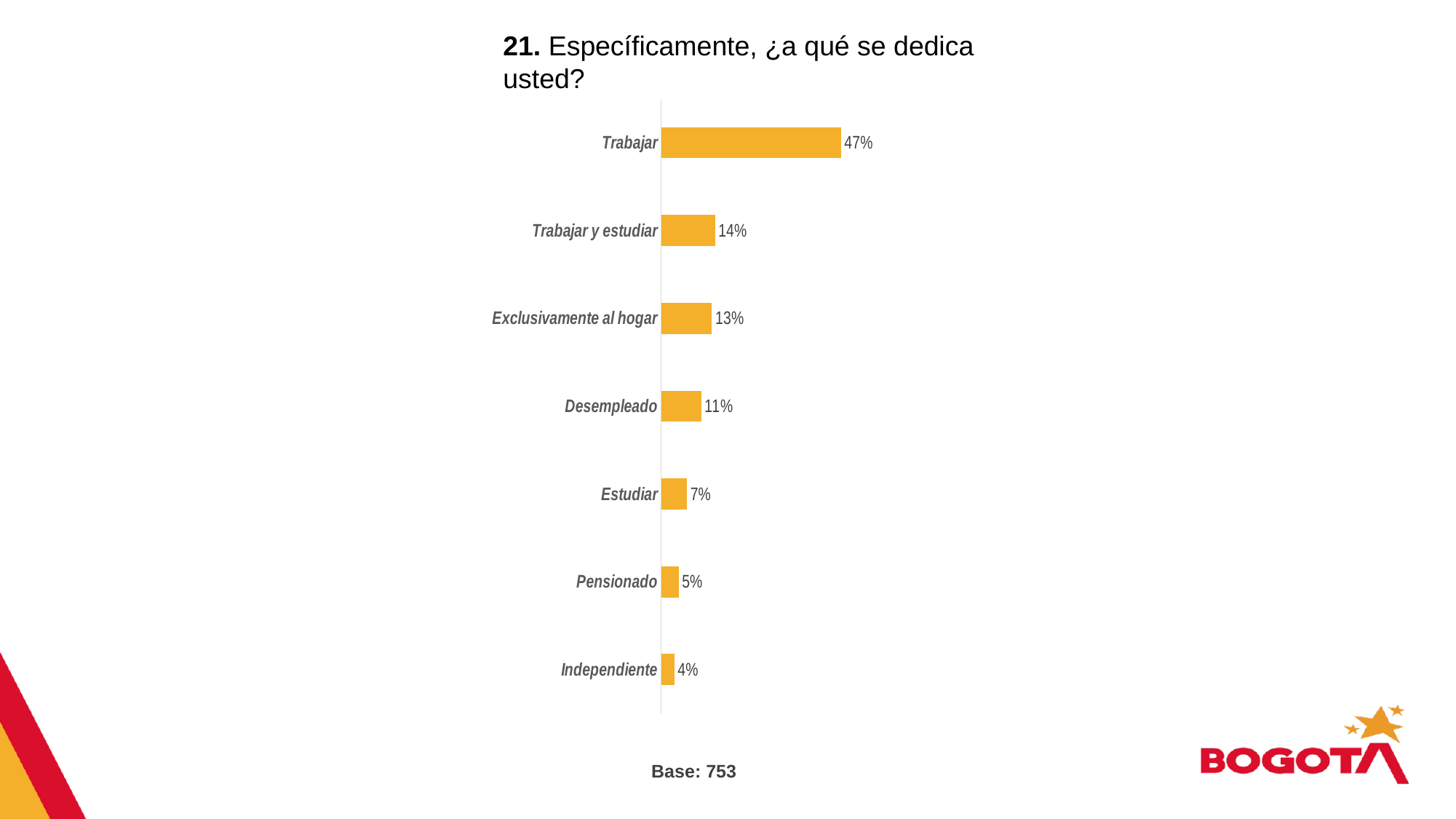
Which category has the lowest value? Independiente Which category has the highest value? Trabajar What is the base (number of respondents) shown below the chart? 753 What is the value for Exclusivamente al hogar? 13% Which is larger, the value for Desempleado or the value for Estudiar? Desempleado What is the value for Trabajar? 47% What is the value for Desempleado? 11% What is the difference between the values for Estudiar and Independiente? 3% What kind of chart is shown on the slide? Bar chart What is the difference between the values for Trabajar and Trabajar y estudiar? 33% What is the value for Pensionado? 5% How many categories are shown in the chart? 7